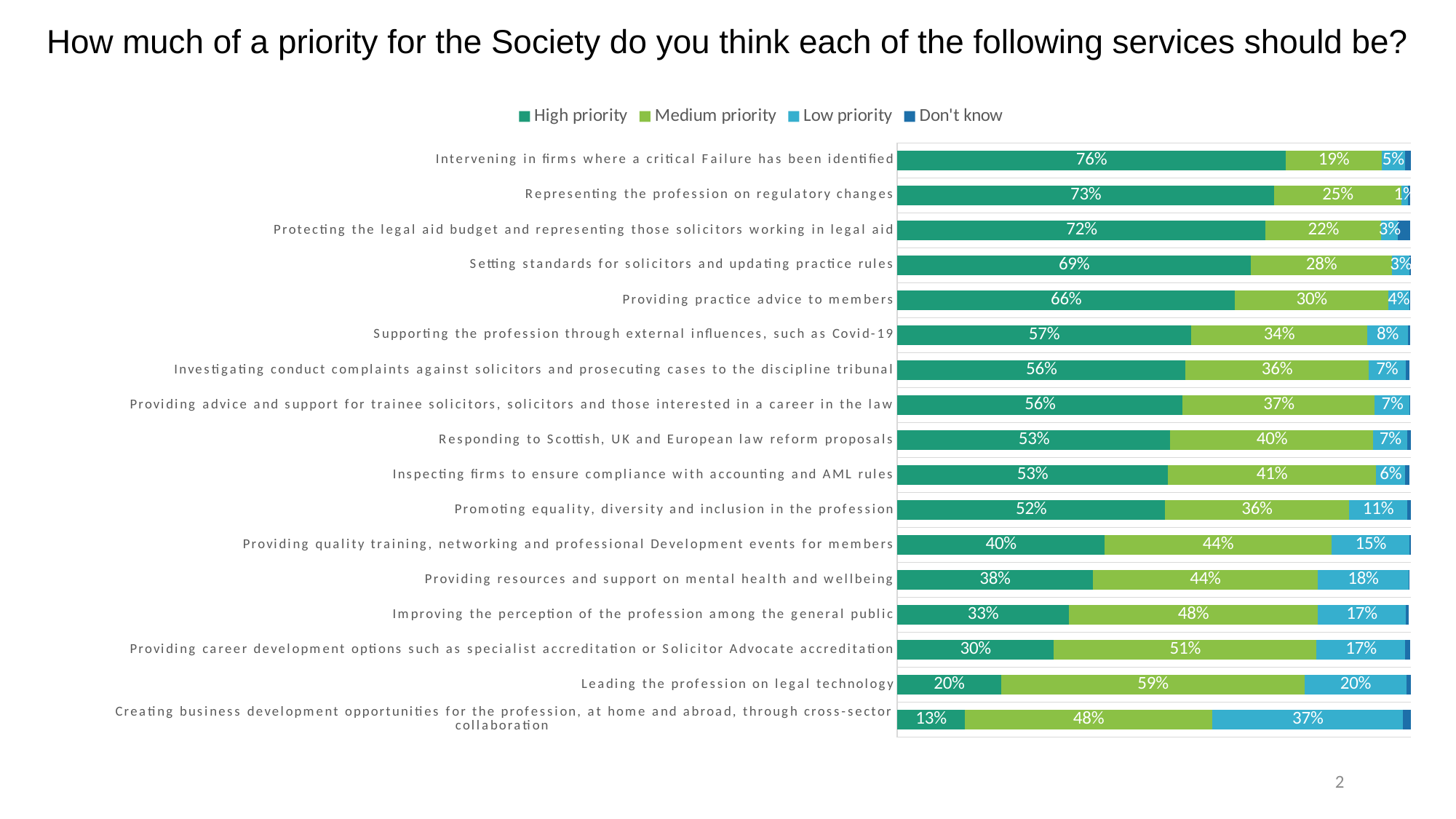
What is the difference between the High priority values for 'Representing the profession on regulatory changes' and 'Providing practice advice to members'? 7% What is the Low priority value for 'Creating business development opportunities for the profession, at home and abroad, through cross-sector collaboration'? 37% How many services (categories) are plotted in the chart? 17 How many series does the legend list? 4 Which service has the lowest High priority value? Creating business development opportunities for the profession, at home and abroad, through cross-sector collaboration What is the High priority value for 'Intervening in firms where a critical Failure has been identified'? 76% What is the Low priority value for 'Providing resources and support on mental health and wellbeing'? 18% Which has a larger Medium priority value: 'Improving the perception of the profession among the general public' or 'Providing career development options such as specialist accreditation or Solicitor Advocate accreditation'? Providing career development options such as specialist accreditation or Solicitor Advocate accreditation Which service has the highest High priority value? Intervening in firms where a critical Failure has been identified Which legend entry is shown in dark blue? Don't know What type of chart is shown on the slide? stacked bar chart What is the Medium priority value for 'Leading the profession on legal technology'? 59%